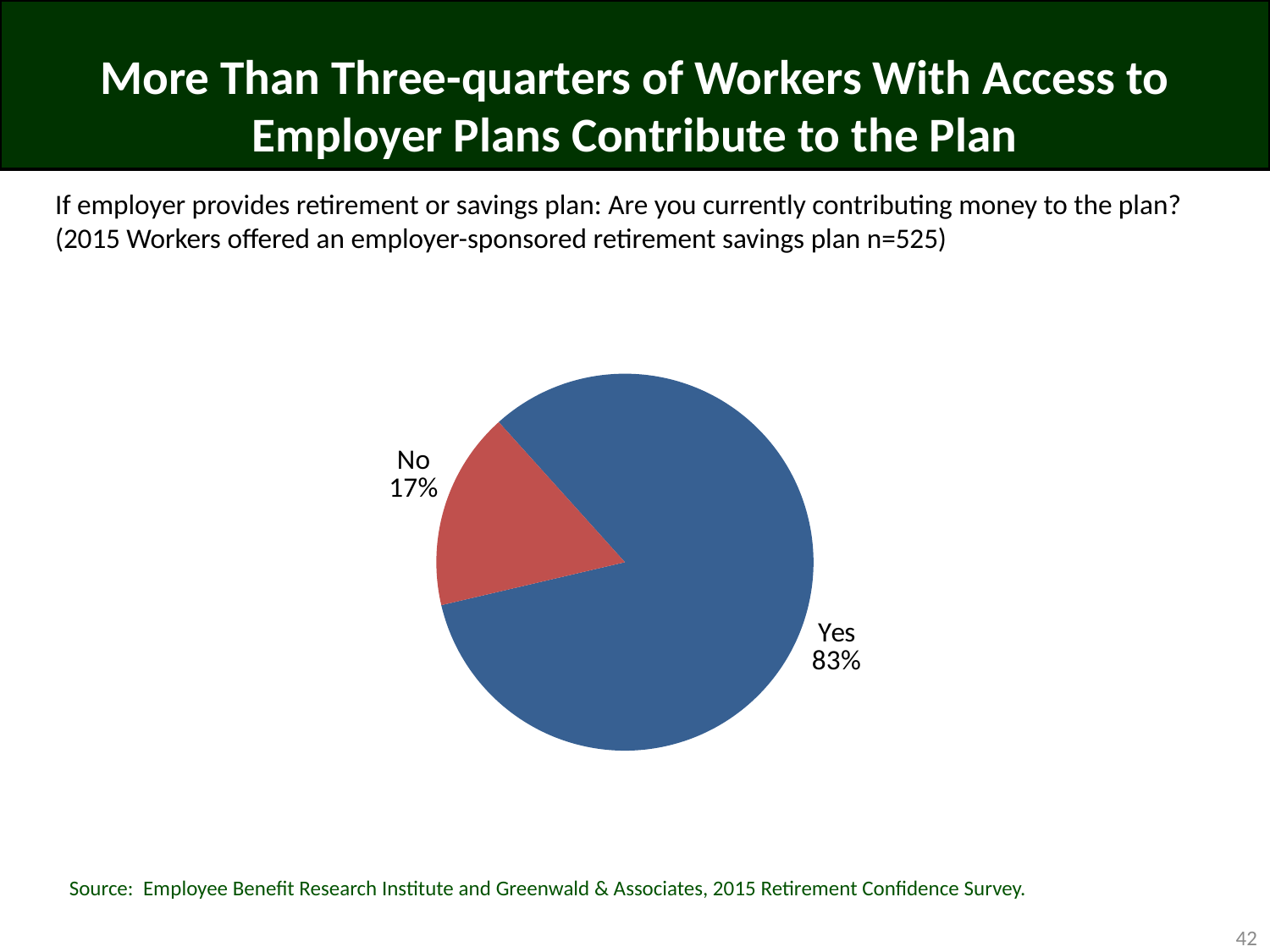
What colour is the "No" slice of the pie? red What percentage of workers answered "Yes" to currently contributing money to the plan? 83% What colour is the "Yes" slice of the pie? blue What percentage of workers answered "No" to currently contributing money to the plan? 17% Which response has the smallest share of the pie? No What is the difference in percentage points between the "Yes" and "No" slices? 66 What kind of chart is shown on the slide? pie chart What is the sample size (n) stated for the survey question shown on the slide? 525 Which slice is larger, "Yes" or "No"? Yes Which response has the largest share of the pie? Yes How many slices does the pie chart have? 2 What share of the pie does the "No" slice represent? 17%